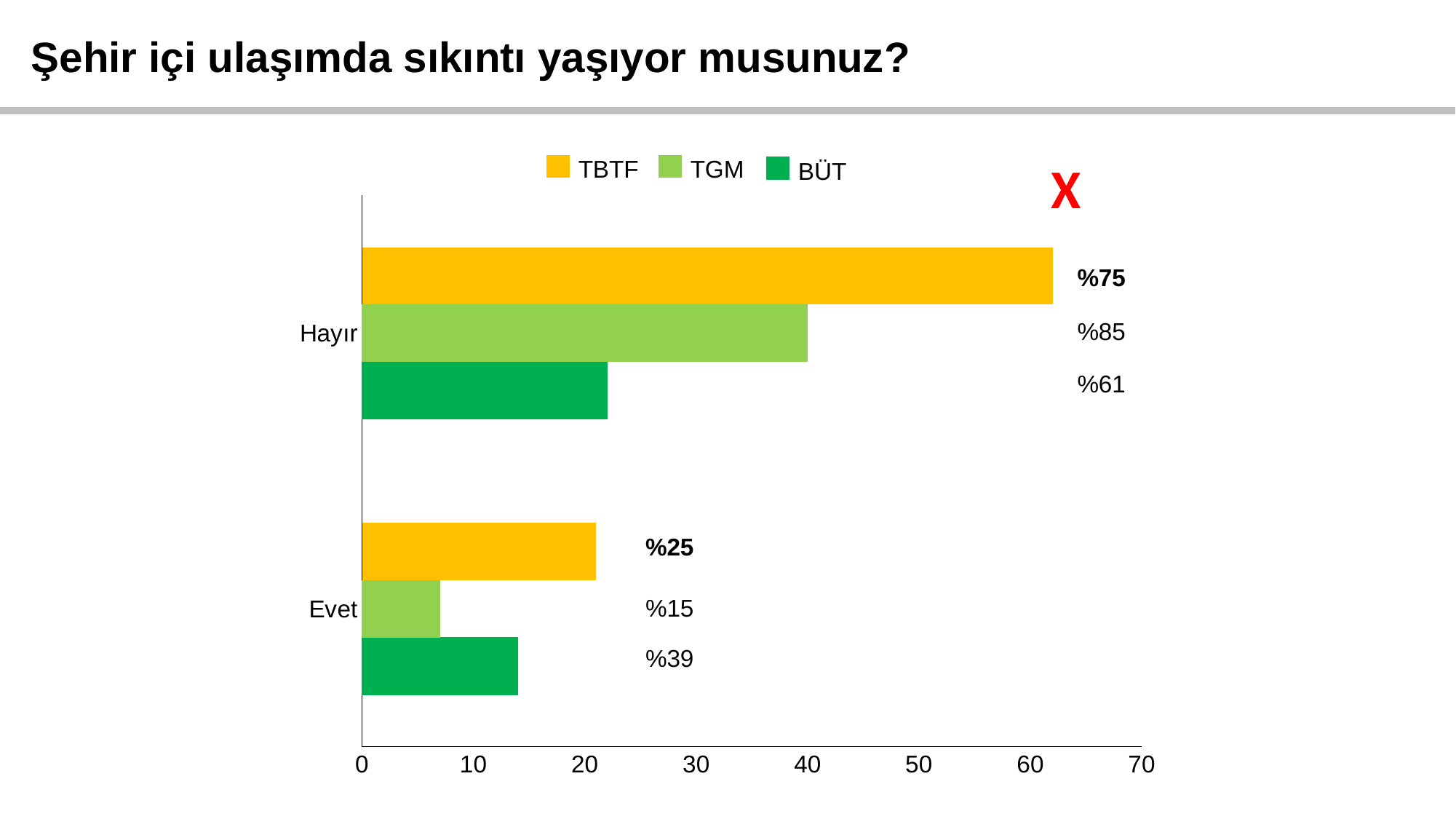
What is the labelled value for TGM in the Hayır category? %85 Which series are listed in the legend? TBTF, TGM, BÜT For the TBTF series, which category has the larger value, Hayır or Evet? Hayır What is the labelled value for BÜT in the Hayır category? %61 What is the labelled value for TBTF in the Evet category? %25 How many series does the legend list? 3 How many categories are shown on the vertical axis? 2 What is the labelled value for BÜT in the Evet category? %39 What is the labelled value for TGM in the Evet category? %15 What is the title of the slide? Şehir içi ulaşımda sıkıntı yaşıyor musunuz? What is the labelled value for TBTF in the Hayır category? %75 What kind of chart is shown on the slide? Bar chart